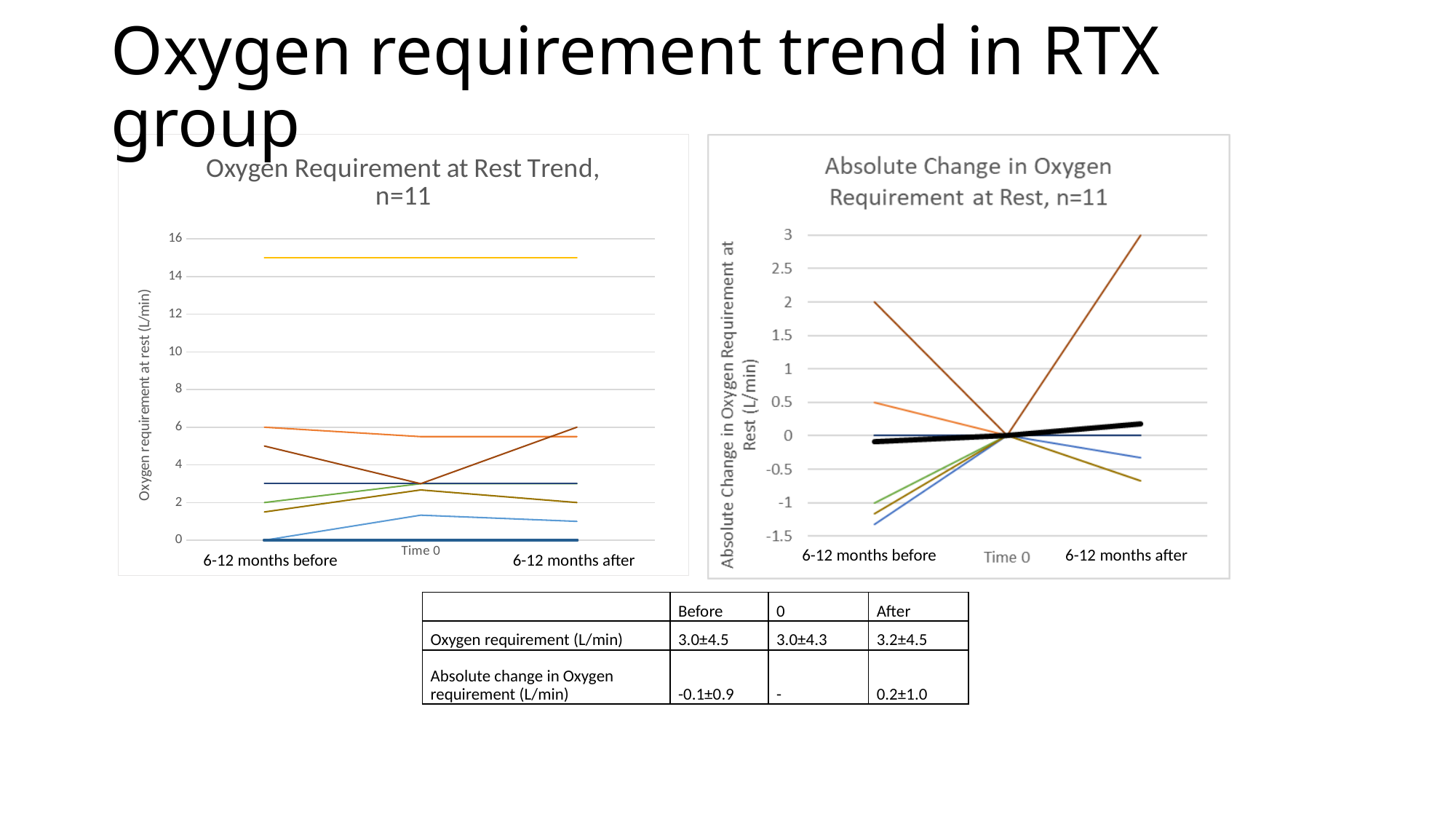
What kind of chart is the 'Absolute Change in Oxygen Requirement at Rest, n=11' chart on the right? line chart What is the title of the chart on the left of the slide? Oxygen Requirement at Rest Trend, n=11 In the right chart, 'Absolute Change in Oxygen Requirement at Rest, n=11', does the thick black line rise or fall from 6-12 months before to 6-12 months after? rises In the right chart, 'Absolute Change in Oxygen Requirement at Rest, n=11', is the value of the thick black line at 6-12 months after greater or less than 1? less What is the y-axis label of the right chart, 'Absolute Change in Oxygen Requirement at Rest, n=11'? Absolute Change in Oxygen Requirement at Rest (L/min) In the right chart, 'Absolute Change in Oxygen Requirement at Rest, n=11', is the value of the highest line at 6-12 months after greater or less than 2.5? greater How many time points are shown on the x axis of the left chart, 'Oxygen Requirement at Rest Trend, n=11'? 3 What kind of chart is the 'Oxygen Requirement at Rest Trend, n=11' chart on the left? line chart In the left chart, 'Oxygen Requirement at Rest Trend, n=11', what value does the lowest line sit at across all three time points? 0 In the left chart, 'Oxygen Requirement at Rest Trend, n=11', is the value of the yellow line at 6-12 months before greater or less than 14? greater How many time points are shown on the x axis of the right chart, 'Absolute Change in Oxygen Requirement at Rest, n=11'? 3 In the right chart, 'Absolute Change in Oxygen Requirement at Rest, n=11', what value do all the lines share at Time 0? 0